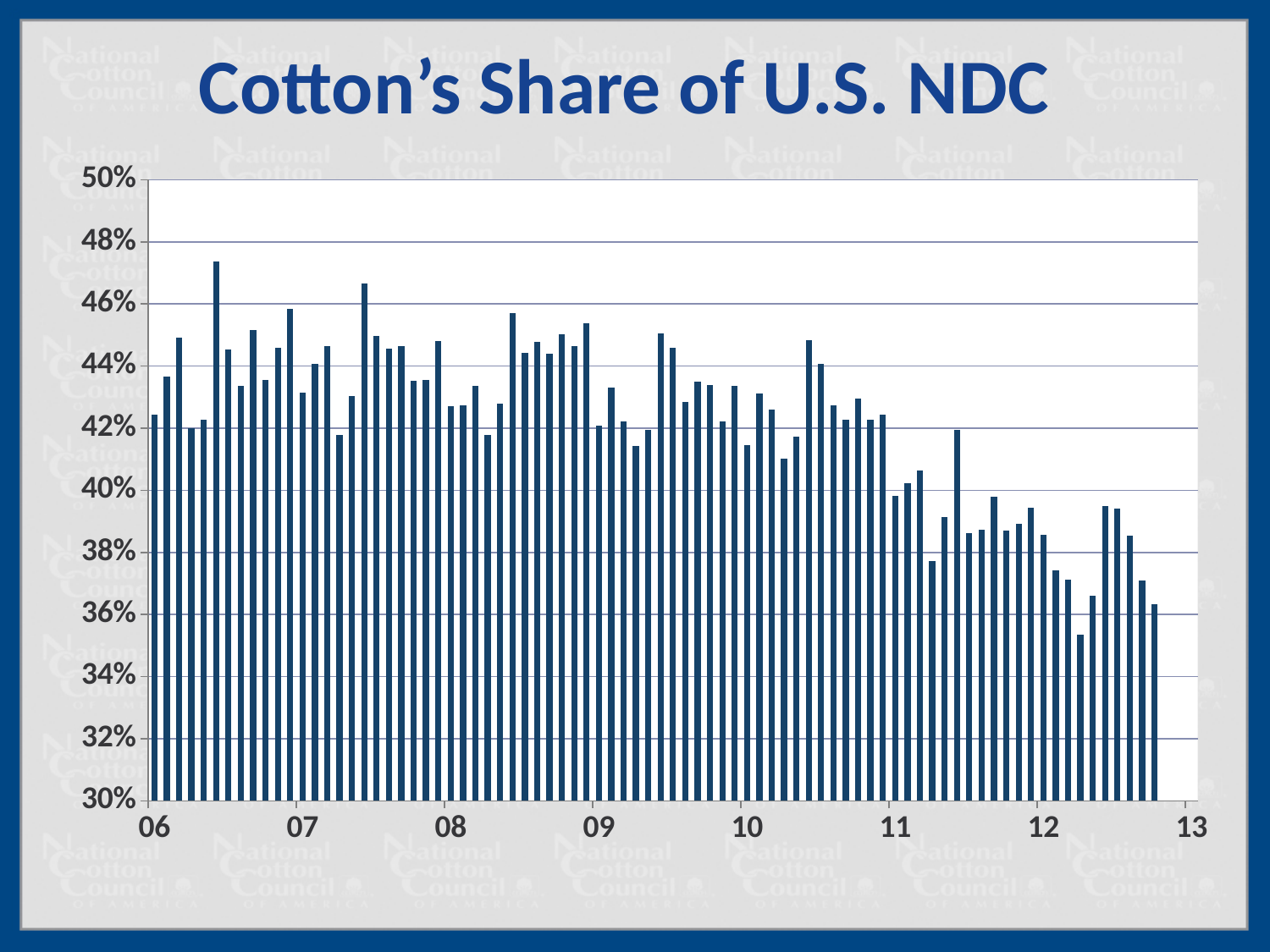
What kind of chart is shown on the slide? Bar chart Is the tallest bar located closer to 06 or to 12 on the x axis? 06 How many year labels are shown on the x axis? 8 Is the tallest bar on the chart greater or less than 46%? greater Do any bars on the chart reach above 48%? No Overall, do the values rise or fall from 06 to 13 along the x axis? Fall What is the title of the chart? Cotton's Share of U.S. NDC Is the shortest bar located closer to 12 or to 08 on the x axis? 12 Is the shortest bar on the chart greater or less than 36%? less Are the bars around 12 on the x axis generally higher or lower than the bars around 07? Lower What is the highest value shown on the y axis? 50%